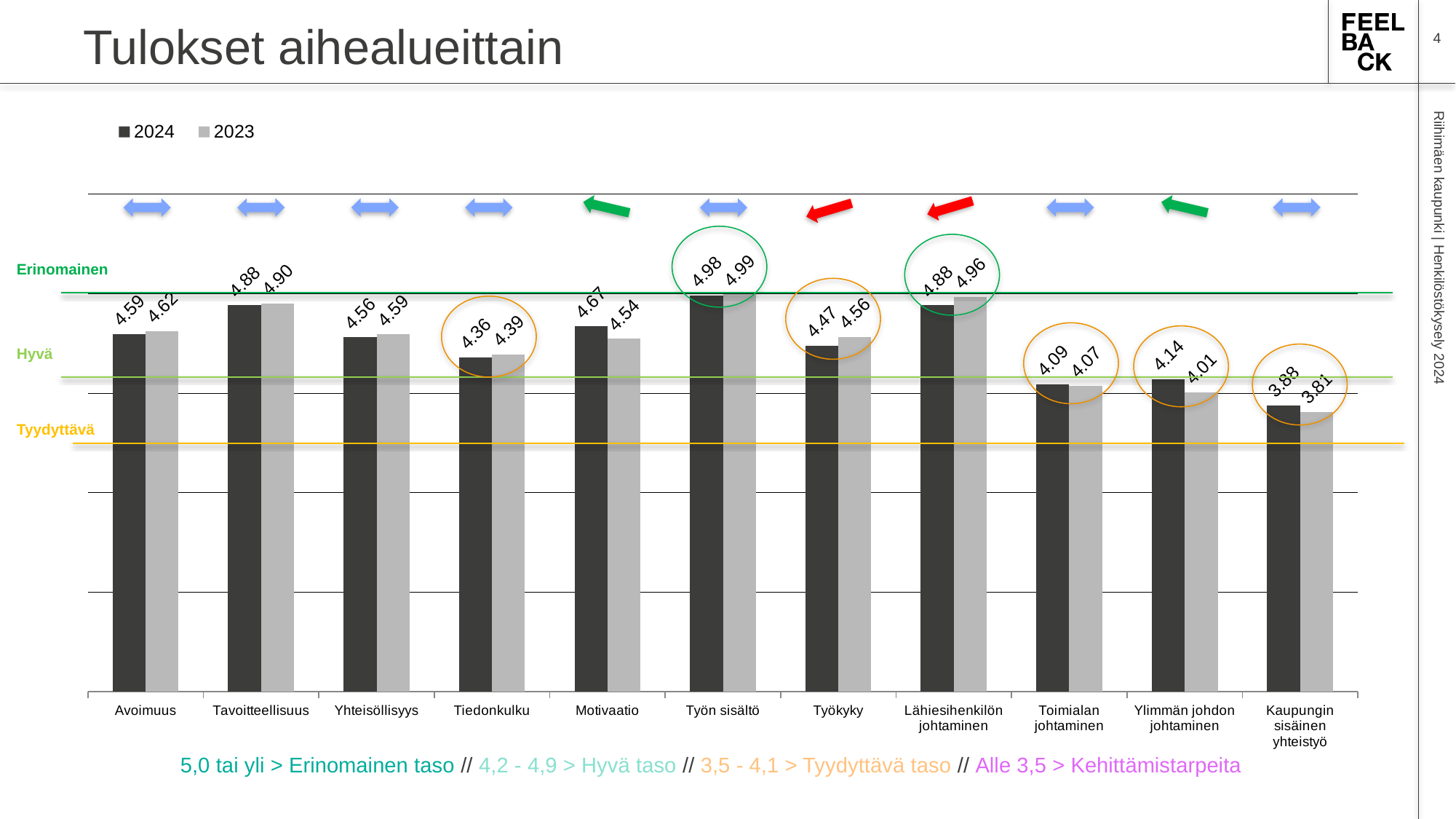
Which series is shown in dark grey bars according to the legend? 2024 Which category has the highest 2024 value? Työn sisältö How many categories are shown on the x axis? 11 Which category has the lowest 2023 value? Kaupungin sisäinen yhteistyö What kind of chart is shown on the slide? Bar chart For Työkyky, which year has the larger value, 2024 or 2023? 2023 What is the 2024 value for Motivaatio? 4.67 How many series does the legend list? 2 What is the difference between the 2023 and 2024 values for Tiedonkulku? 0.03 What is the 2023 value for Lähiesihenkilön johtaminen? 4.96 What is the difference between the 2024 and 2023 values for Ylimmän johdon johtaminen? 0.13 What is the 2024 value for Kaupungin sisäinen yhteistyö? 3.88